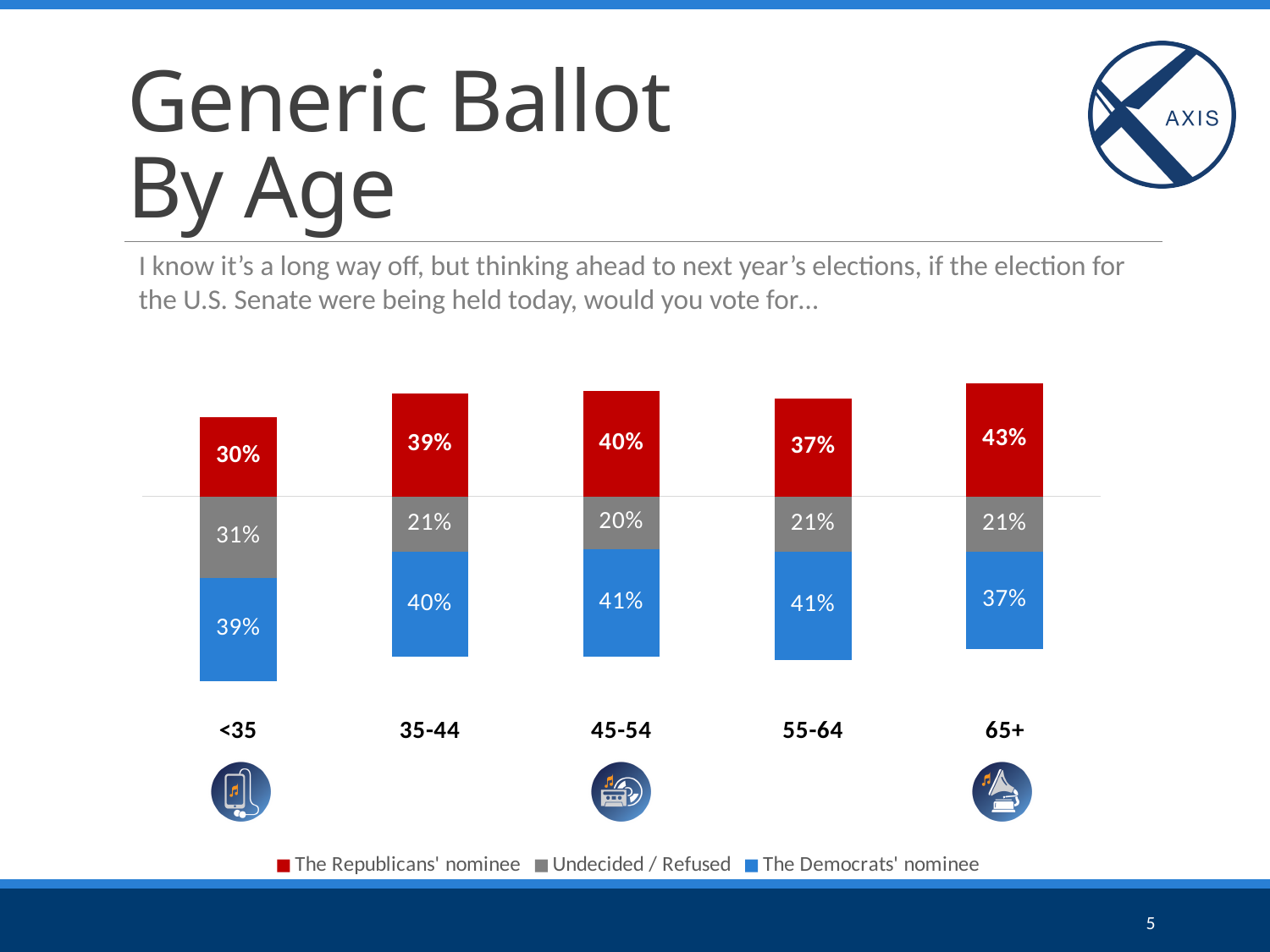
What kind of chart is shown on the slide? Stacked bar chart In the 65+ age group, which is larger: the Republicans' nominee value or the Democrats' nominee value? The Republicans' nominee What is the total of the stacked bar for the <35 age group? 100% What percentage of the 65+ age group would vote for the Democrats' nominee? 37% How many series does the legend list? 3 What is the Undecided / Refused value for the 45-54 age group? 20% What percentage of the <35 age group would vote for the Republicans' nominee? 30% How many age groups are shown on the x axis? 5 What is the difference between the Republicans' nominee values for the 65+ and <35 age groups? 13% Which age group has the lowest value for the Republicans' nominee? <35 Which age group has the highest value for the Republicans' nominee? 65+ Which age group has the highest Undecided / Refused value? <35